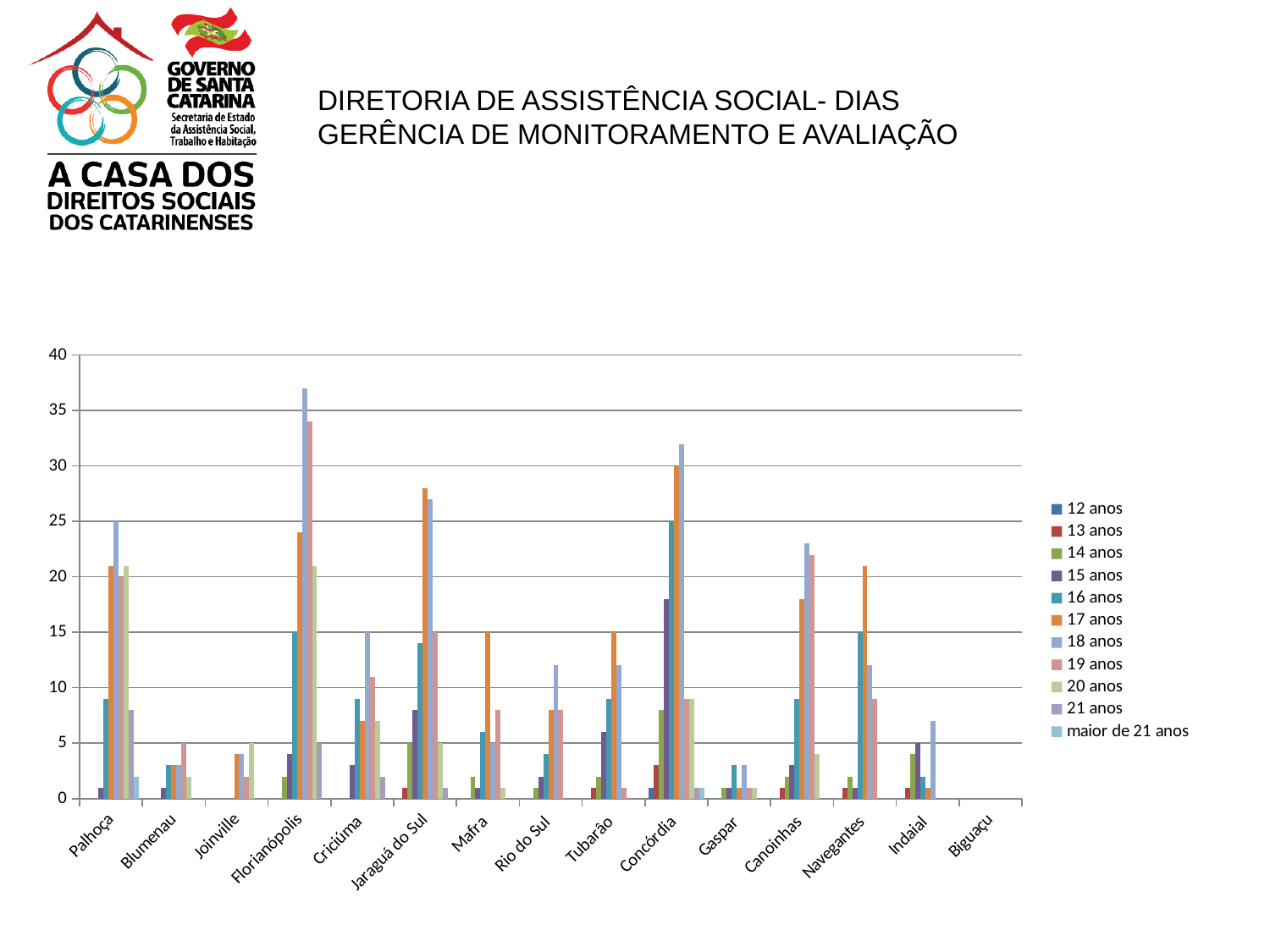
What is the last series listed in the chart's legend? maior de 21 anos Which is larger: the 17 anos value for Jaraguá do Sul or the 17 anos value for Criciúma? Jaraguá do Sul Is the value for 18 anos in Concórdia greater or less than 30? greater Which is larger: the 18 anos value for Florianópolis or the 18 anos value for Concórdia? Florianópolis Is the value for 17 anos in Navegantes greater or less than 20? greater Is the value for 18 anos in Florianópolis greater or less than 35? greater What kind of chart is shown on the slide? bar chart Which municipality has the tallest bar in the chart? Florianópolis How many categories (municipalities) are shown on the x axis of the chart? 15 How many series does the chart's legend list? 11